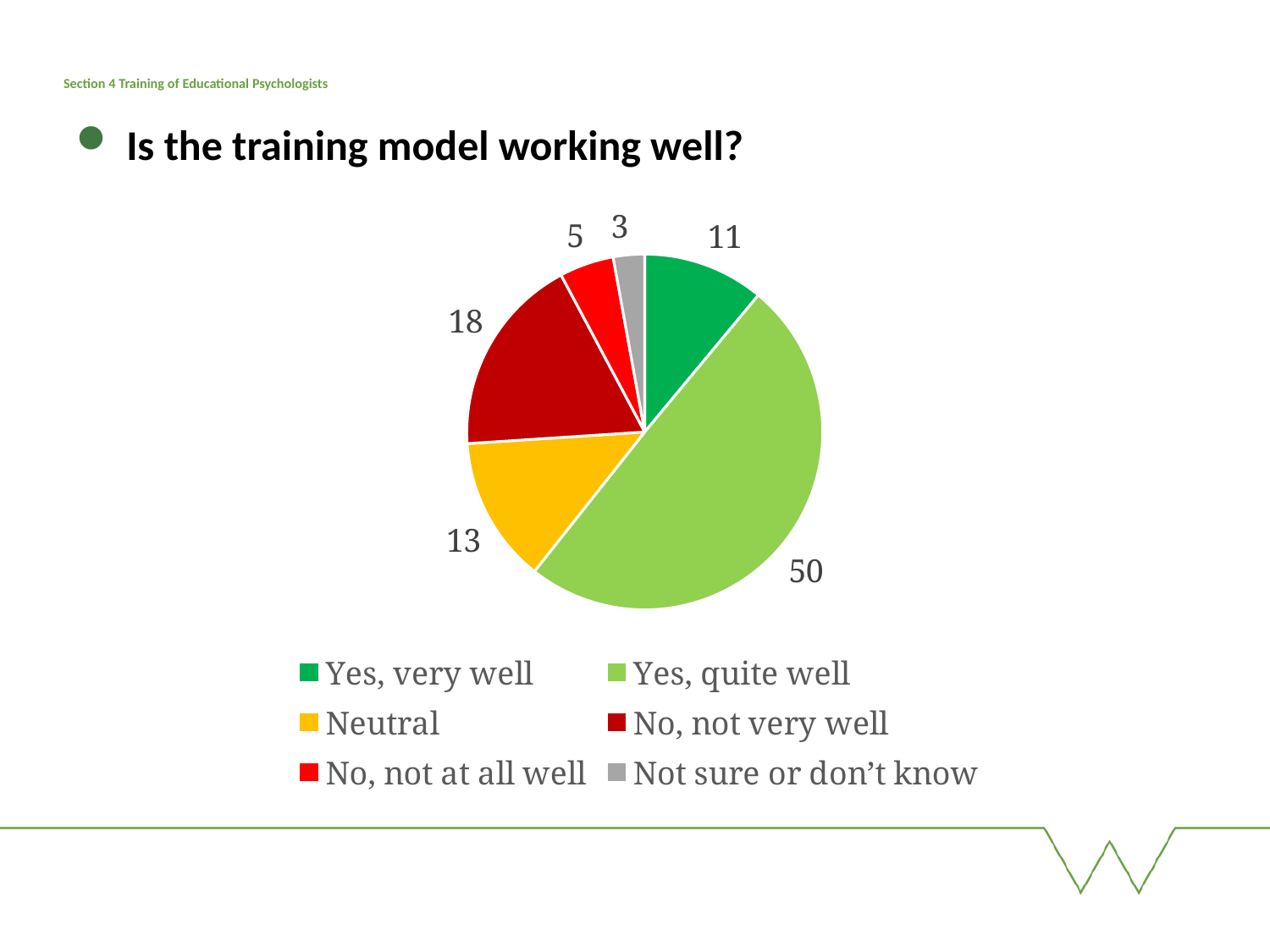
Which is larger, the value for "Neutral" or the value for "Yes, very well"? Neutral What is the difference between the values for "No, not very well" and "Yes, very well"? 7 How many categories does the pie chart show? 6 What value is shown for the "No, not very well" slice? 18 Which category has the smallest slice of the pie? Not sure or don't know What colour is the "Neutral" slice in the pie chart? Yellow What value is shown for the "Neutral" slice? 13 What share of the pie does the "Yes, quite well" slice represent? 50% What value is shown for the "Not sure or don't know" slice? 3 What kind of chart is shown on the slide? Pie chart What value is shown for the "Yes, quite well" slice? 50 Which category has the largest slice of the pie? Yes, quite well